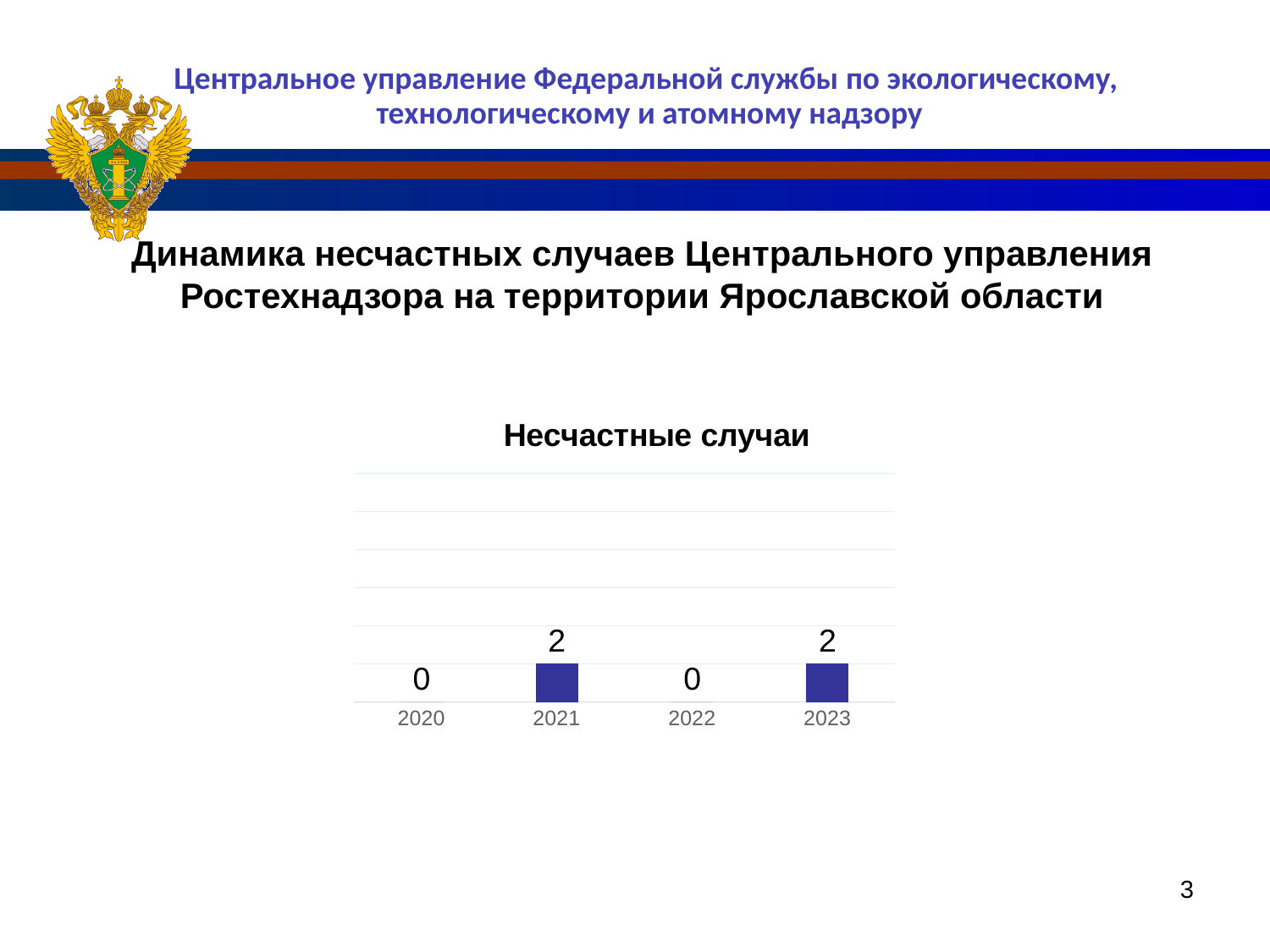
What is the difference between the values for 2023 and 2021? 0 What is the value for 2020 in the chart? 0 Which years have a value of 0 in the chart? 2020 and 2022 Which is larger, the value for 2023 or the value for 2022? 2023 What is the value for 2023 in the chart? 2 What colour are the bars in the chart? blue What is the value for 2022 in the chart? 0 What kind of chart is shown on the slide? bar chart How many categories (years) are shown on the x axis of the chart? 4 What is the difference between the values for 2021 and 2020? 2 What is the value for 2021 in the chart? 2 What is the title of the chart? Несчастные случаи